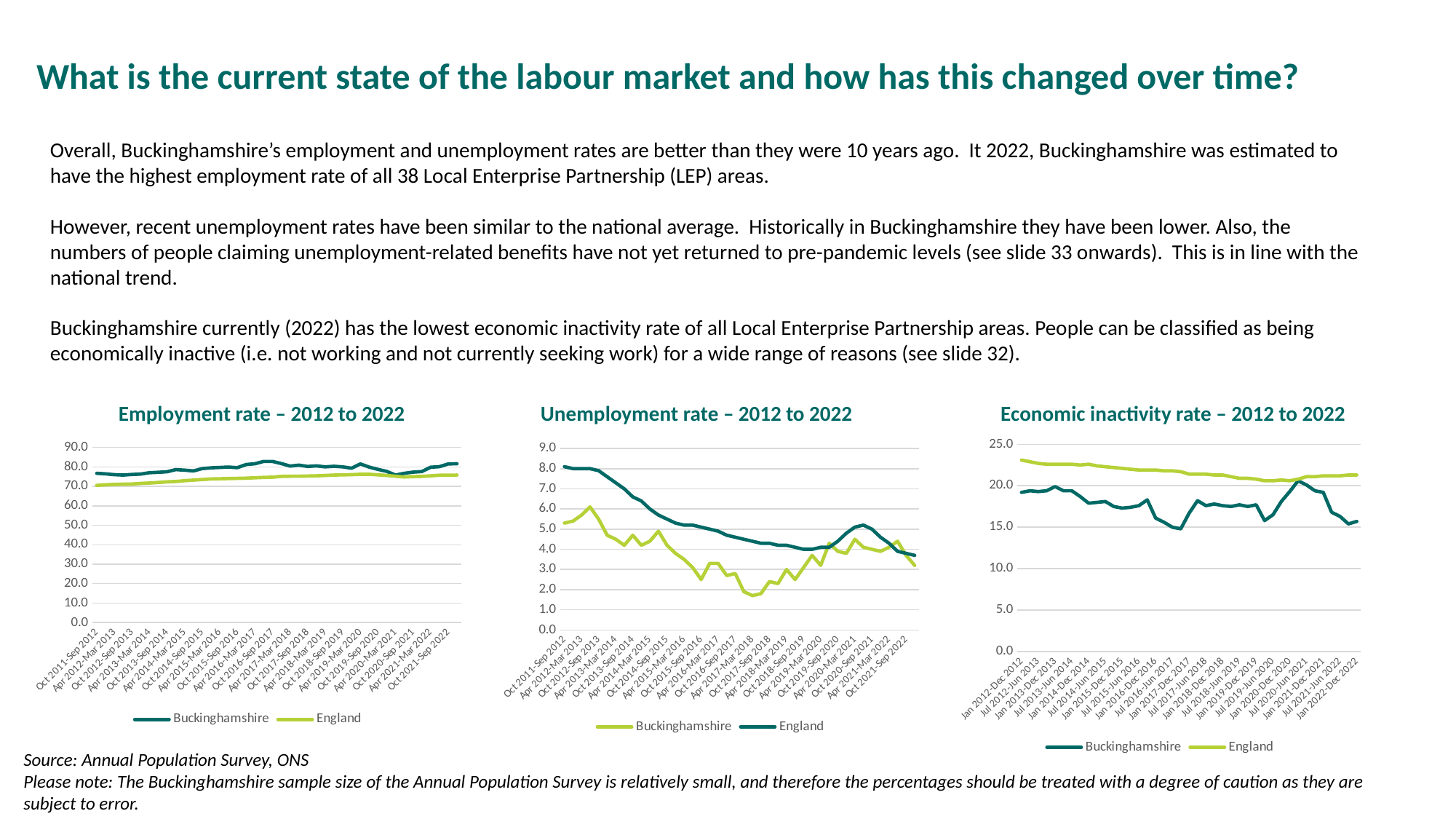
What kind of chart is the 'Employment rate – 2012 to 2022' chart? line chart In the 'Economic inactivity rate – 2012 to 2022' chart, is the value for England at Jan 2012-Dec 2012 greater or less than 20.0? greater In the 'Unemployment rate – 2012 to 2022' chart, does the England line rise or fall overall from Oct 2011-Sep 2012 to Oct 2021-Sep 2022? fall In the 'Unemployment rate – 2012 to 2022' chart, which series is higher at Oct 2011-Sep 2012, Buckinghamshire or England? England In the 'Employment rate – 2012 to 2022' chart, which series is higher at Oct 2011-Sep 2012, Buckinghamshire or England? Buckinghamshire In the 'Economic inactivity rate – 2012 to 2022' chart, which series is higher at Jan 2022-Dec 2022, Buckinghamshire or England? England In the 'Economic inactivity rate – 2012 to 2022' chart, is the value for Buckinghamshire at Jan 2022-Dec 2022 greater or less than 20.0? less What is the title of the middle chart on the slide? Unemployment rate – 2012 to 2022 In the 'Unemployment rate – 2012 to 2022' chart, is the value for England at Oct 2011-Sep 2012 greater or less than 7.0? greater How many series does the legend of the 'Unemployment rate – 2012 to 2022' chart list? 2 In the 'Employment rate – 2012 to 2022' chart, does the England line rise or fall from Oct 2011-Sep 2012 to Oct 2021-Sep 2022? rise